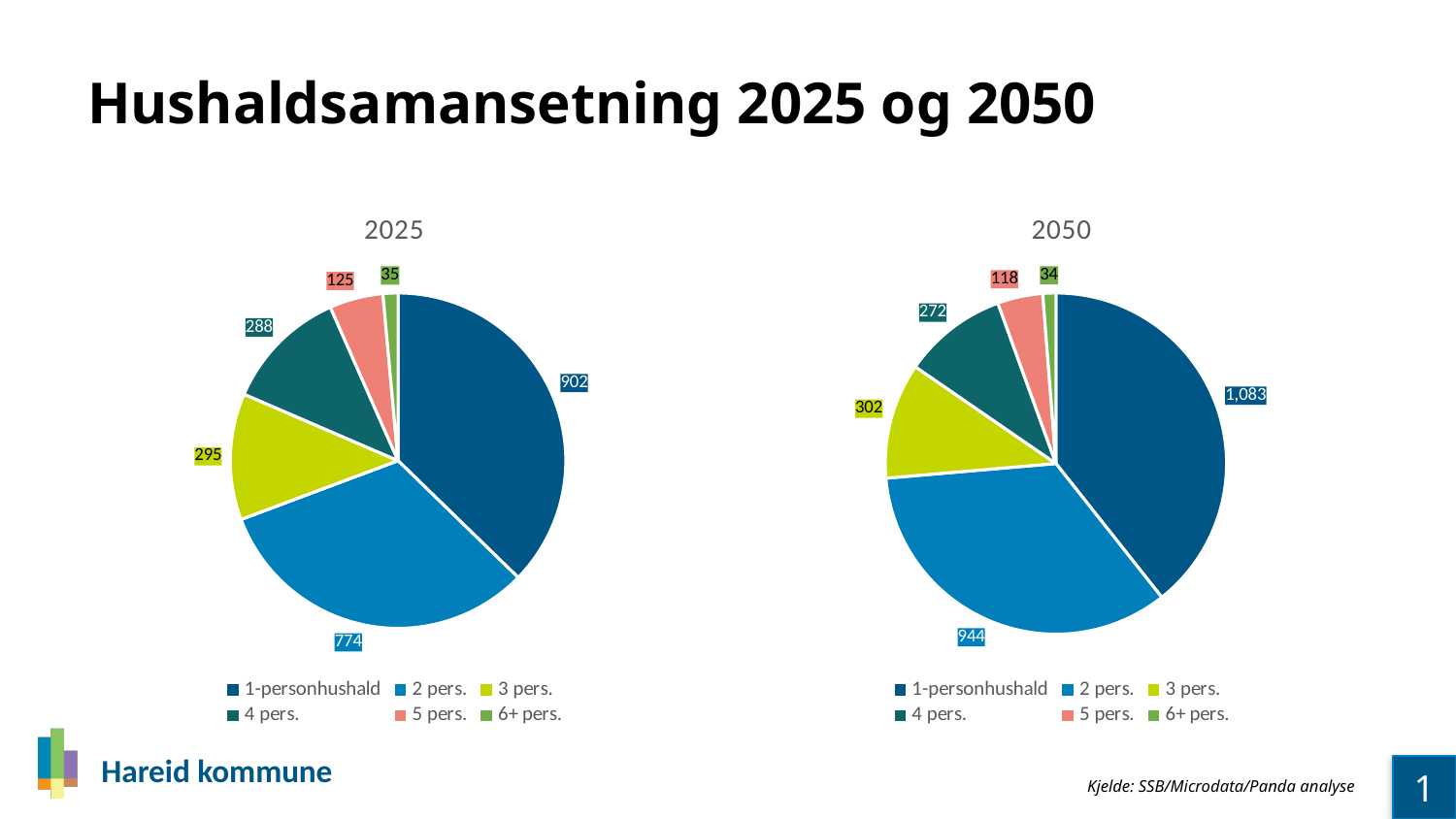
Which is larger: the value for 4 pers. in the 2025 chart or the value for 4 pers. in the 2050 chart? 2025 (288) In the 2025 pie chart, what is the value for 1-personhushald? 902 How many slices does the 2025 pie chart have? 6 In the 2050 pie chart, which category has the smallest slice? 6+ pers. In the 2050 pie chart, what is the value for 3 pers.? 302 In the 2025 pie chart, what is the value for 5 pers.? 125 In the 2050 pie chart, what is the value for 2 pers.? 944 In the 2025 pie chart, what is the difference between the values for 3 pers. and 4 pers.? 7 What type of chart is used for the 2050 data? Pie chart In the 2025 pie chart, which category has the largest slice? 1-personhushald What is the source cited at the bottom of the slide? SSB/Microdata/Panda analyse In the 2050 pie chart, what is the difference between the values for 1-personhushald and 2 pers.? 139